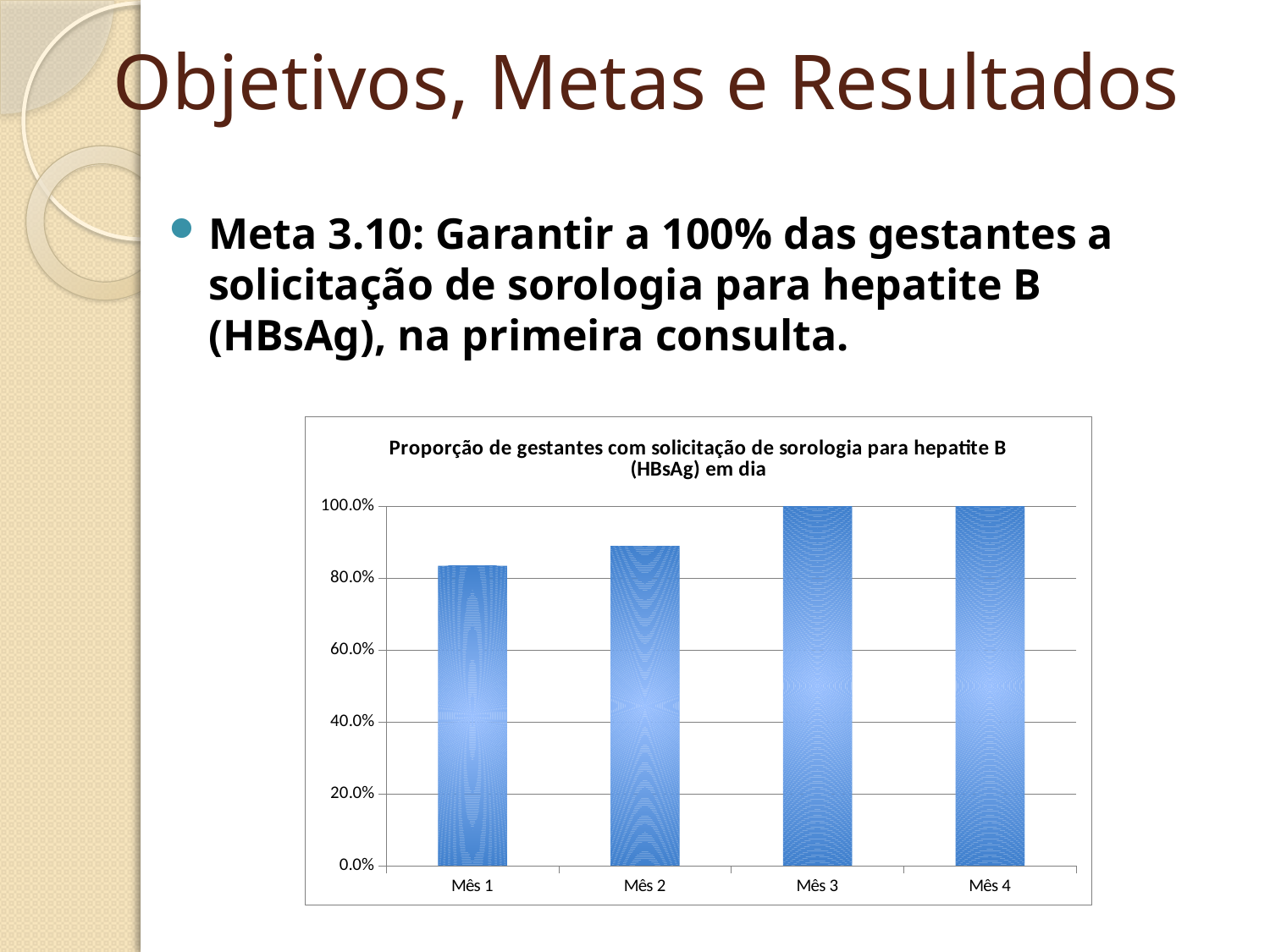
Is the value for Mês 1 greater or less than 100.0%? less Which is larger, the value for Mês 1 or the value for Mês 2? Mês 2 What is the title of the chart? Proporção de gestantes com solicitação de sorologia para hepatite B (HBsAg) em dia Do the values rise or fall from Mês 1 to Mês 4? Rise What is the value for Mês 4 in the chart? 100.0% What kind of chart is shown on the slide? Bar chart What is the value for Mês 3 in the chart? 100.0% Which month has the lowest value in the chart? Mês 1 What is the highest value shown on the y axis of the chart? 100.0% Is the value for Mês 2 greater or less than 100.0%? less Is the value for Mês 1 greater or less than 80.0%? greater How many categories (months) are shown on the x axis of the chart? 4